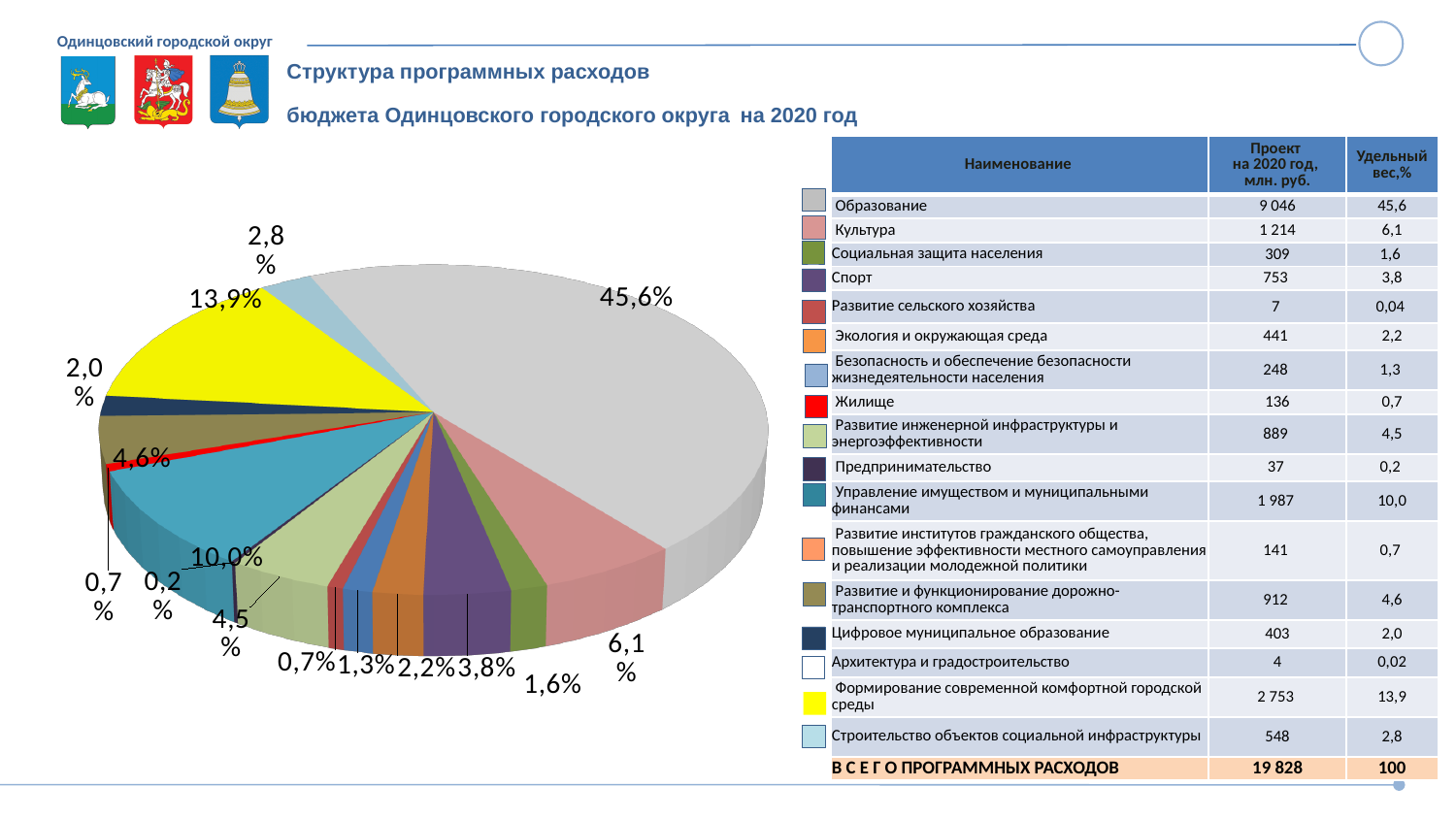
What is the largest share shown on the pie chart? 45,6% Which category has the largest slice of the pie chart? Образование How many categories does the table next to the pie chart list (excluding the total row)? 17 What is the total of programme expenditures (ВСЕГО ПРОГРАММНЫХ РАСХОДОВ) in млн руб. shown in the table? 19 828 What share of the pie chart does Формирование современной комфортной городской среды (yellow slice) have? 13,9% What share does Управление имуществом и муниципальными финансами have on the pie chart? 10,0% What is the title of the chart on the slide? Структура программных расходов бюджета Одинцовского городского округа на 2020 год What kind of chart is shown on the slide? Pie chart What is the planned 2020 amount for Образование in млн руб. according to the table? 9 046 What is the difference in percentage points between the Образование slice (45,6%) and the Формирование современной комфортной городской среды slice (13,9%)? 31,7 Which has the larger share, Строительство объектов социальной инфраструктуры or Цифровое муниципальное образование? Строительство объектов социальной инфраструктуры Which has the larger share on the pie chart, Культура or Спорт? Культура